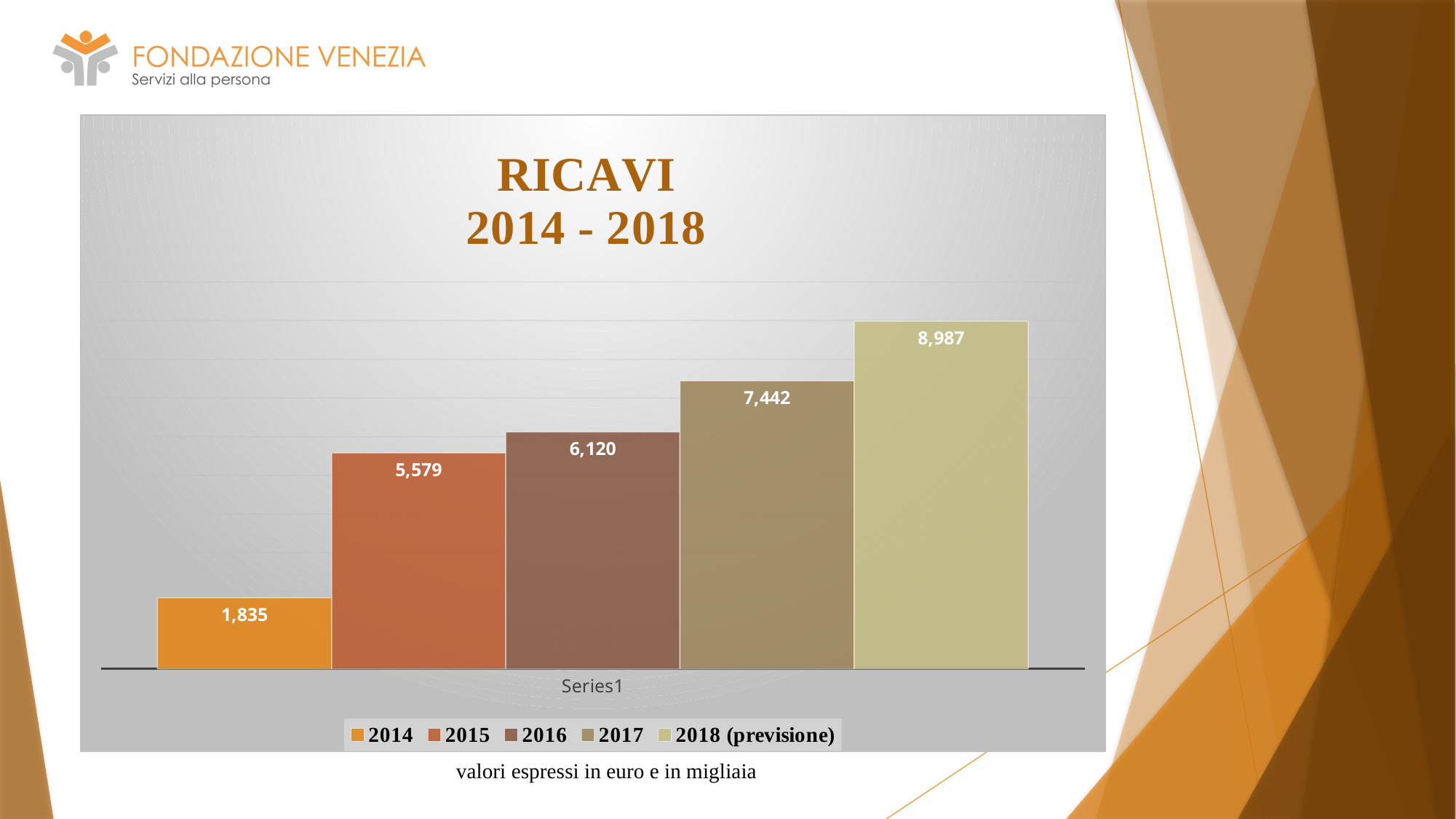
What is the difference between the values for 2015 and 2014? 3,744 Do the values rise or fall from 2014 to 2018 (previsione)? rise What is the difference between the values for 2017 and 2016? 1,322 How many bars are plotted in the chart? 5 What is the value for 2016? 6,120 Which year has the highest value? 2018 (previsione) How many entries does the legend list? 5 What kind of chart is shown? bar chart Which is larger, the value for 2015 or the value for 2017? 2017 Which year has the lowest value? 2014 What is the value for 2018 (previsione)? 8,987 What is the value for 2014? 1,835